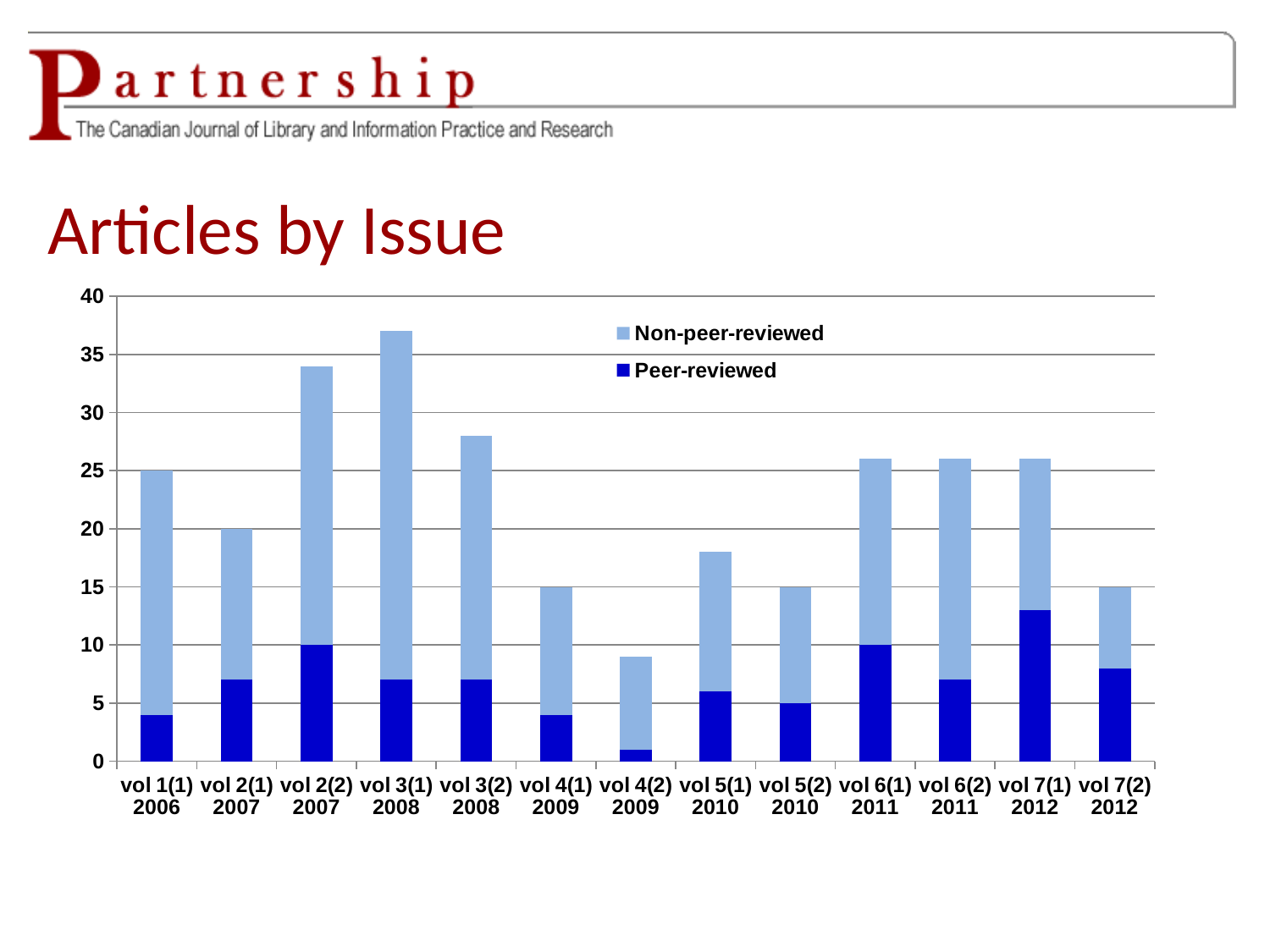
What is the Peer-reviewed value for vol 2(2) 2007? 10 How many issues (categories) are shown on the x axis? 13 What kind of chart is shown on the slide? stacked bar chart Which issue has the larger Peer-reviewed value, vol 7(1) 2012 or vol 6(2) 2011? vol 7(1) 2012 Which series is shown in dark blue in the legend? Peer-reviewed How many series does the legend list? 2 Is the total for vol 3(1) 2008 greater or less than 35? greater Which issue has the tallest total bar? vol 3(1) 2008 Which issue has the shortest total bar? vol 4(2) 2009 What is the total height of the bar for vol 1(1) 2006? 25 What is the total height of the bar for vol 2(1) 2007? 20 Is the total for vol 4(2) 2009 greater or less than 10? less